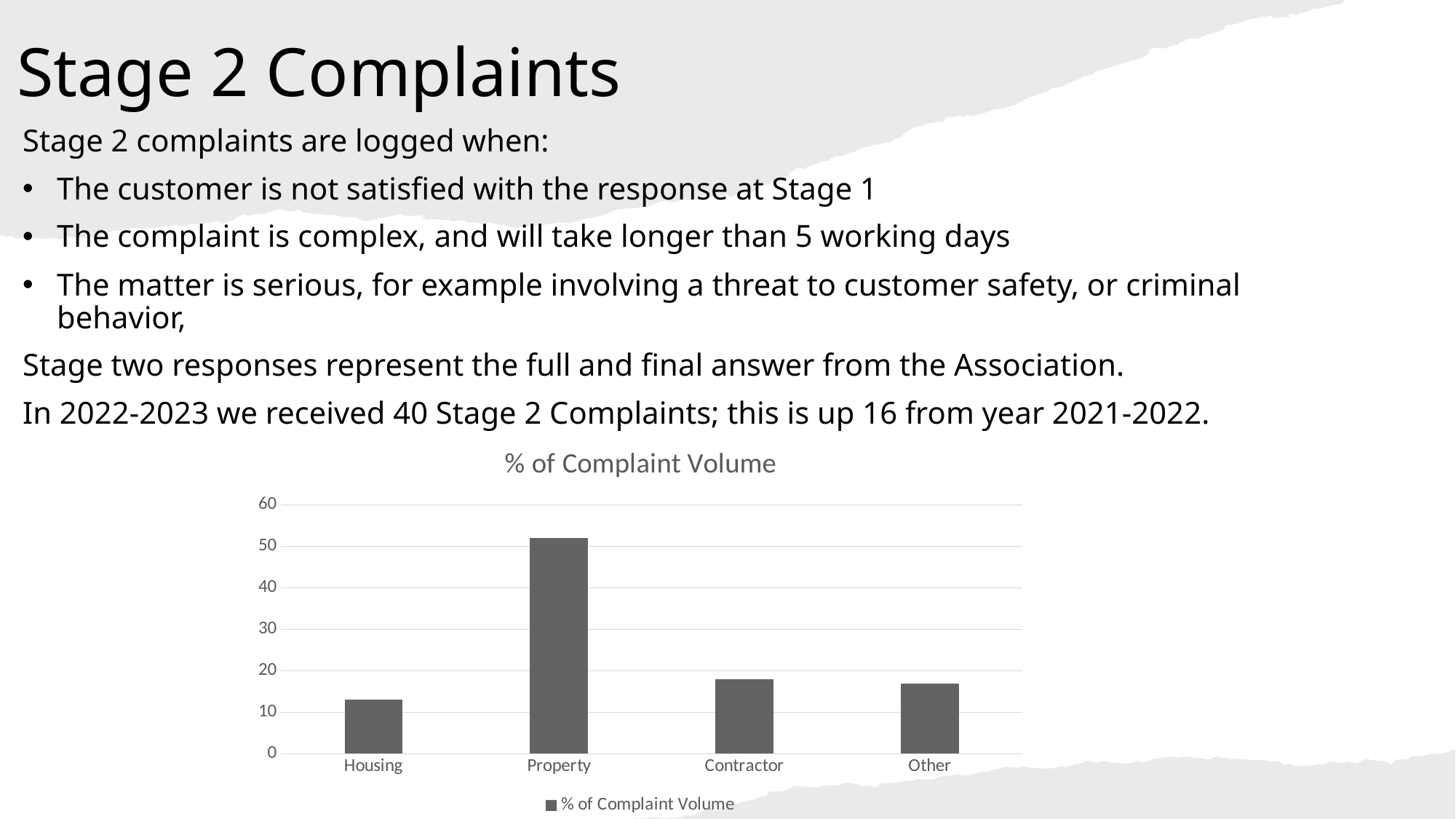
Is the value for Contractor greater or less than 10? greater Is the value for Property greater or less than 40? greater Is the value for Other greater or less than 30? less What is the highest value shown on the y axis of the chart? 60 How many series does the chart legend list? 1 How many categories are shown on the x axis of the chart? 4 Which category has the highest % of Complaint Volume? Property Which category has the lowest % of Complaint Volume? Housing What is the title of the chart? % of Complaint Volume What type of chart is shown on the slide? bar chart Which is larger, the value for Property or the value for Contractor? Property